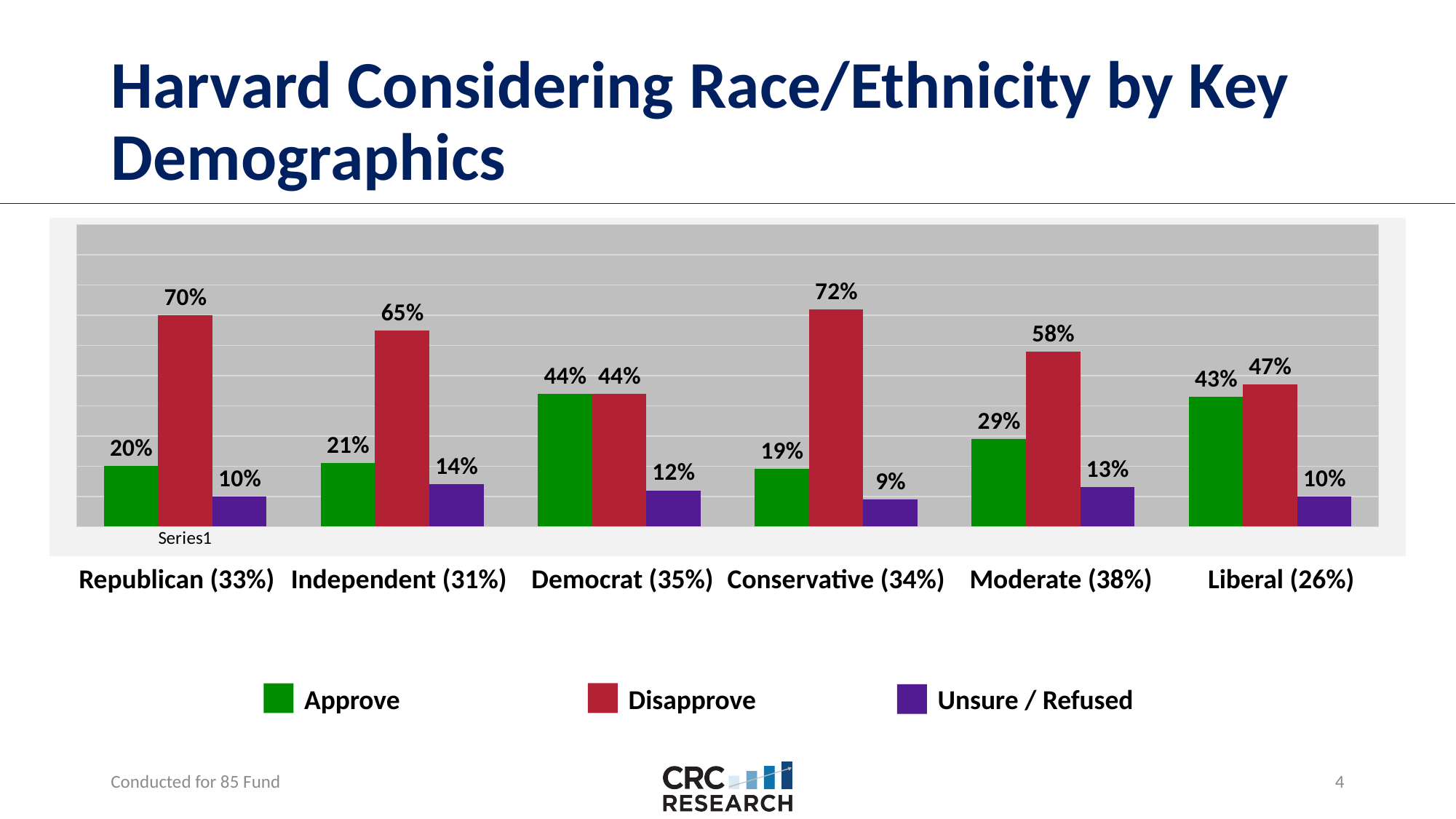
What kind of chart is shown on the slide? Bar chart What is the difference between the Disapprove and Approve values for Republican (33%)? 50% What is the Disapprove value for Conservative (34%)? 72% What is the Approve value for Democrat (35%)? 44% Which colour represents the Unsure / Refused series? Purple What is the Unsure / Refused value for Independent (31%)? 14% How many demographic groups are shown on the x axis? 6 Which group has the highest Disapprove value? Conservative (34%) Which is larger for Liberal (26%): the Approve value or the Disapprove value? Disapprove How many series does the legend list? 3 What is the total of the Approve and Disapprove values for Moderate (38%)? 87% Which group has the lowest Approve value? Conservative (34%)